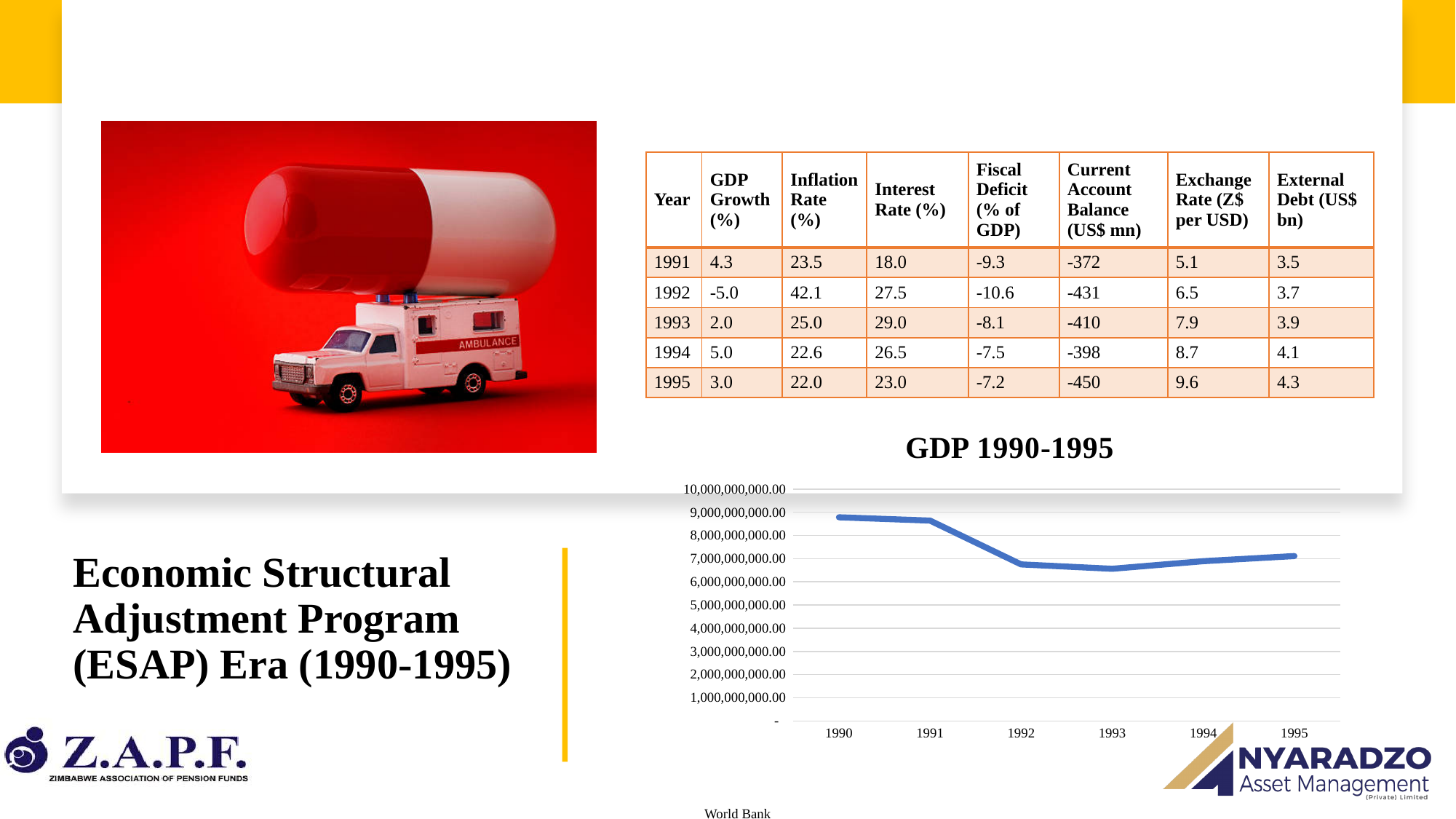
In the GDP 1990-1995 chart, is the value for 1991 greater or less than 8,000,000,000.00? greater How many years are plotted on the x axis of the GDP 1990-1995 chart? 6 In the GDP 1990-1995 chart, which is larger, the value for 1991 or the value for 1993? 1991 In the GDP 1990-1995 chart, is the value for 1992 greater or less than 7,000,000,000.00? less What is the title of the chart on the slide? GDP 1990-1995 In the GDP 1990-1995 chart, is the value for 1993 greater or less than 7,000,000,000.00? less In the GDP 1990-1995 chart, does GDP rise or fall between 1991 and 1992? fall What source is cited below the GDP 1990-1995 chart? World Bank In the GDP 1990-1995 chart, which is larger, the value for 1990 or the value for 1995? 1990 What kind of chart is the "GDP 1990-1995" chart? line chart